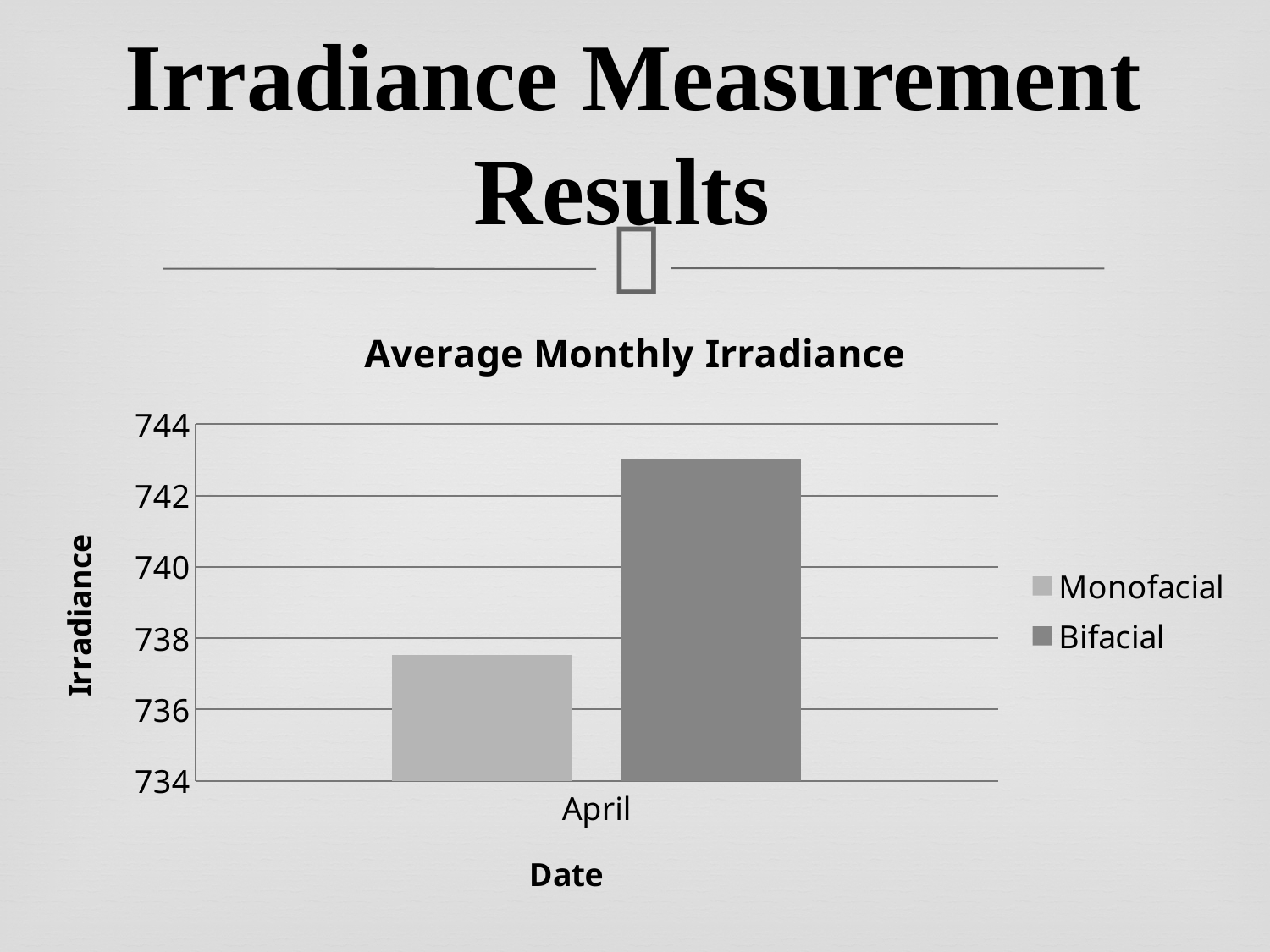
Is the Monofacial value for April greater or less than 740? less What is the title of the chart on the slide? Average Monthly Irradiance How many series does the legend of the Average Monthly Irradiance chart list? 2 Is the Bifacial value for April greater or less than 742? greater What is the label of the x axis of the chart? Date What kind of chart is shown on the slide? bar chart Which series has the highest bar in the Average Monthly Irradiance chart? Bifacial How many categories are shown on the x axis of the Average Monthly Irradiance chart? 1 Which series has the lowest bar in the Average Monthly Irradiance chart? Monofacial Which series has the higher irradiance value for April, Monofacial or Bifacial? Bifacial What category label appears on the x axis of the chart? April Is the Monofacial value for April greater or less than 736? greater